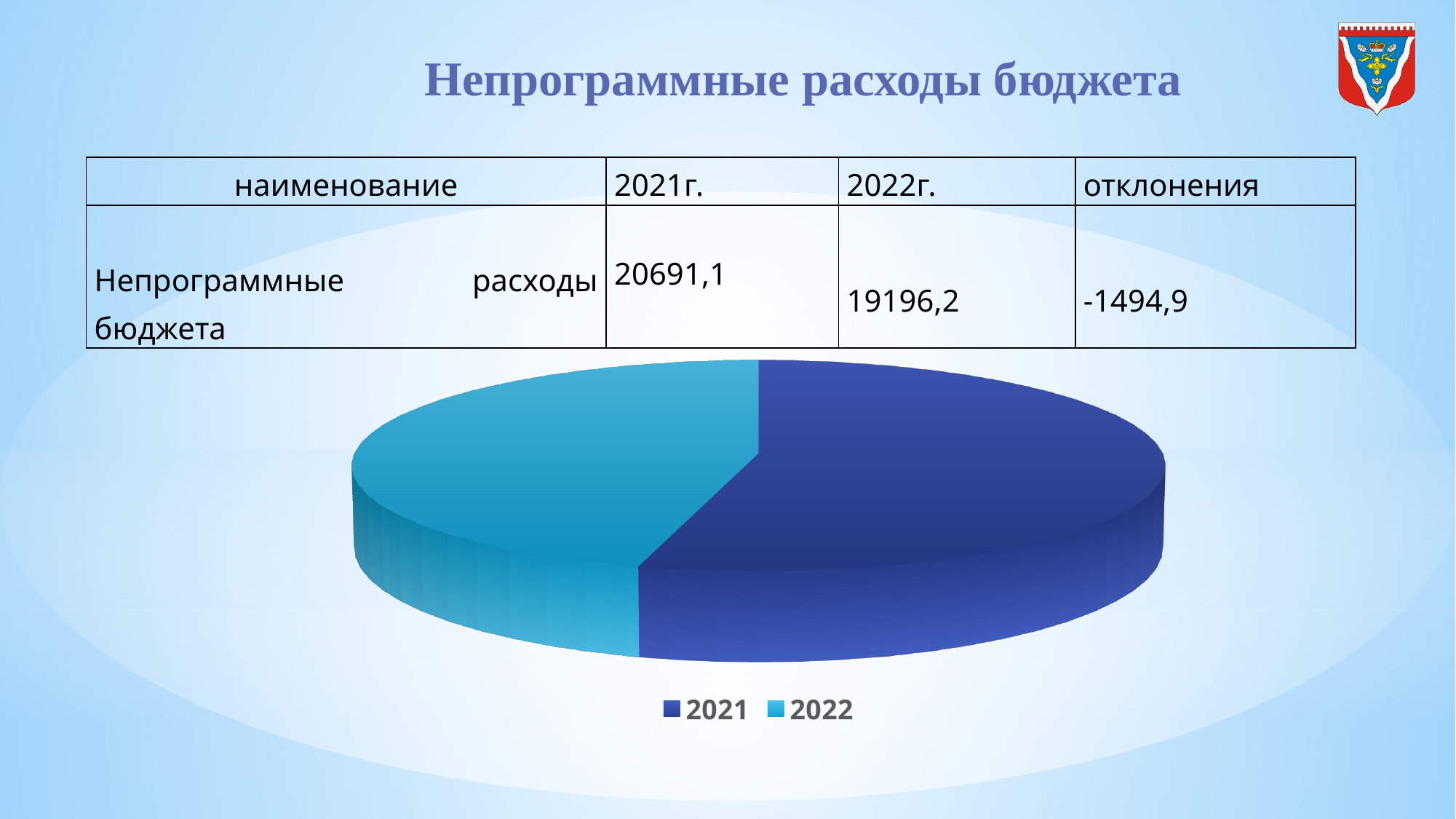
Which is larger in the pie chart, the 2021 slice or the 2022 slice? 2021 Which slice of the pie chart is the largest? 2021 How many slices does the pie chart have? 2 What kind of chart is shown on the slide? pie chart How many entries does the legend of the pie chart list? 2 Which slice of the pie chart is the smallest? 2022 What is the value of non-programme budget expenditure for 2021 shown on the slide? 20691,1 What is the value of non-programme budget expenditure for 2022 shown on the slide? 19196,2 What deviation (отклонения) between 2022 and 2021 is shown on the slide? -1494,9 By how much does the 2021 value exceed the 2022 value? 1494,9 What is the title of the slide containing the pie chart? Непрограммные расходы бюджета What colour is the 2022 slice in the pie chart? light blue